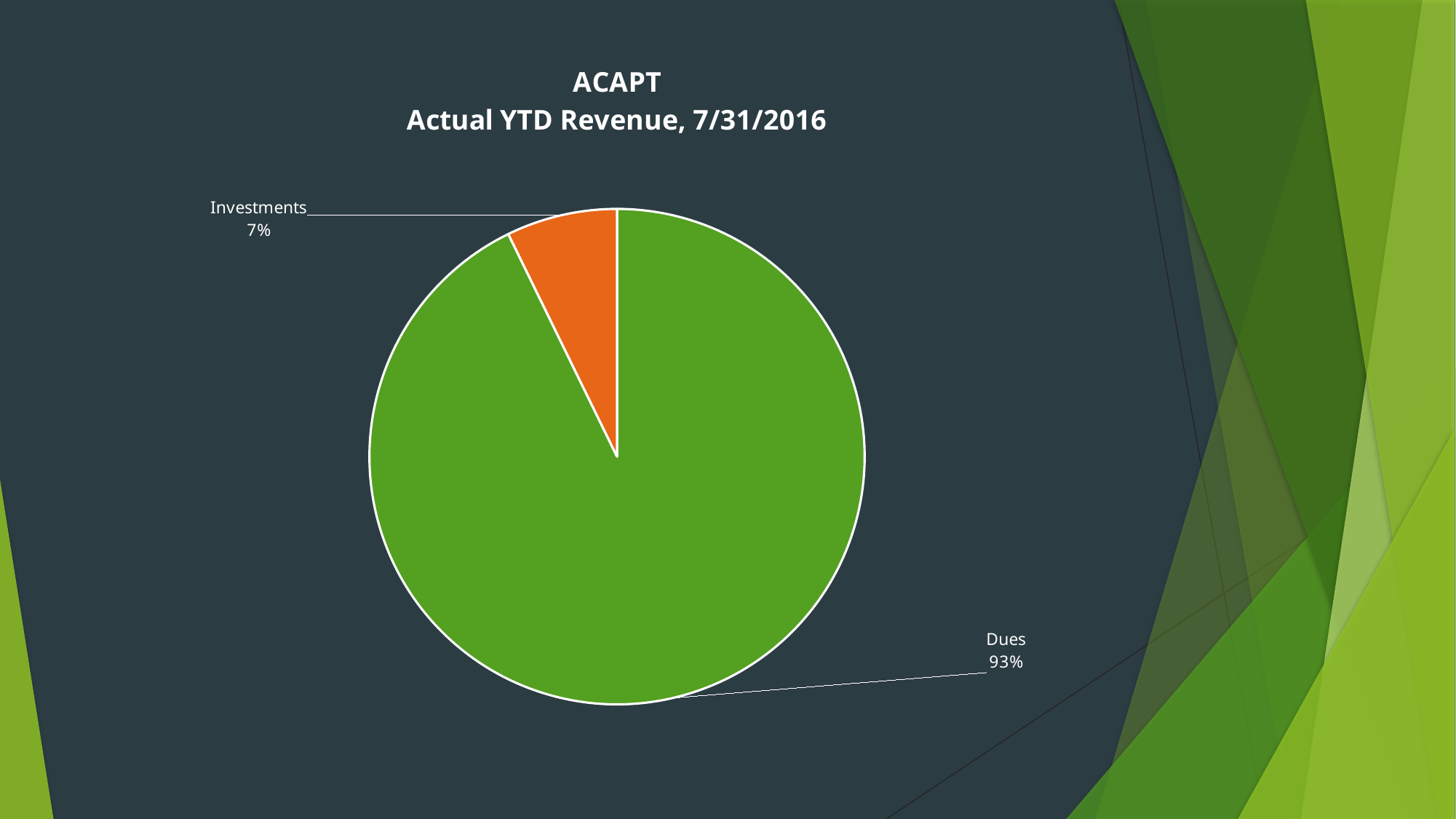
What is the difference in percentage points between the Dues and Investments slices? 86 Is the share for Dues greater or less than 50%? greater Which category has the smallest slice of the pie? Investments How many slices does the pie chart have? 2 Which is larger, the Dues slice or the Investments slice? Dues Which category has the largest slice of the pie? Dues What colour is the Investments slice? orange What share of the pie does Dues represent? 93% What kind of chart is shown on the slide? pie chart What is the combined share of the Dues and Investments slices? 100% What share of the pie does Investments represent? 7% What is the title of the chart? ACAPT Actual YTD Revenue, 7/31/2016